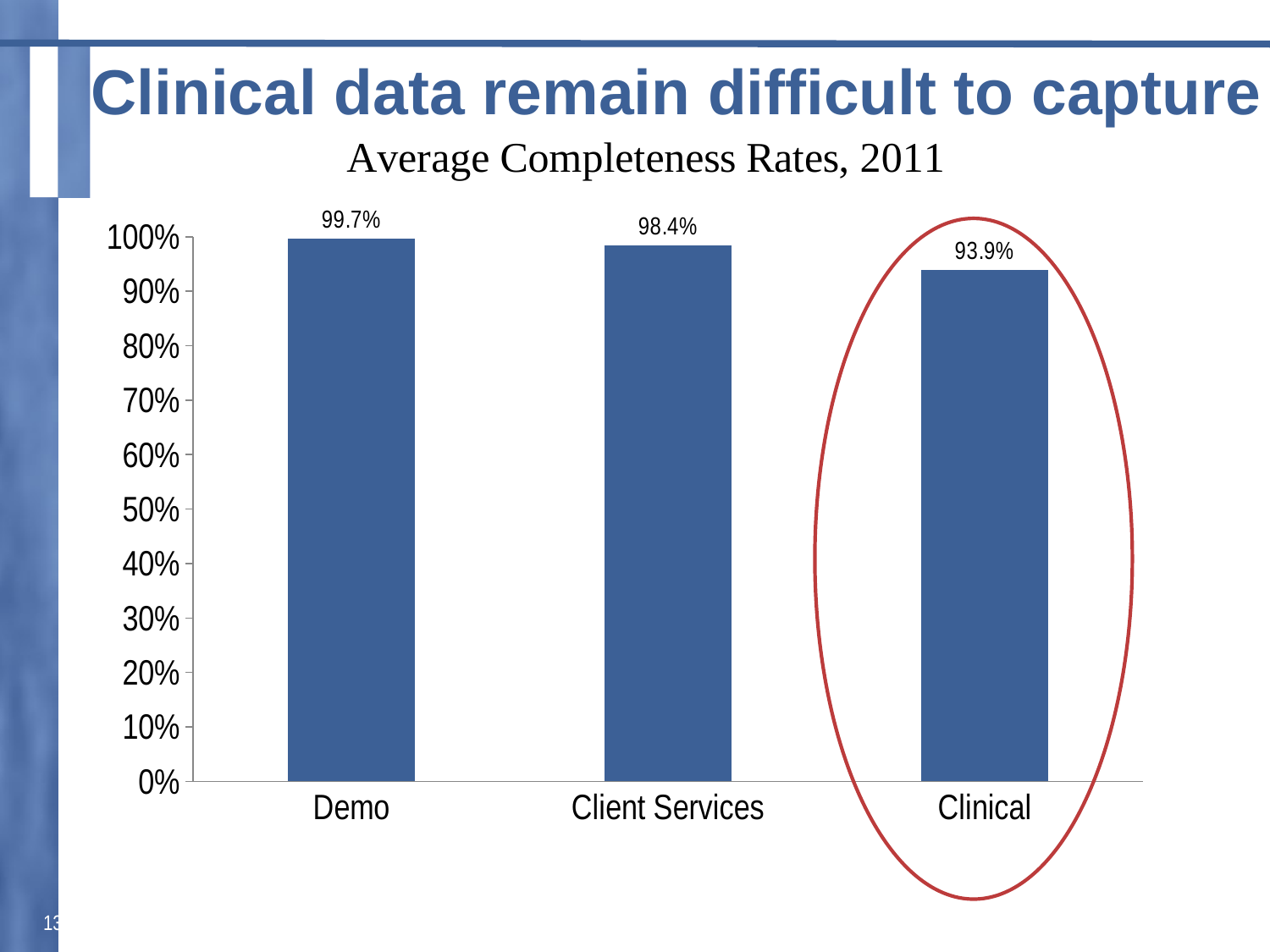
Which category has the highest average completeness rate? Demo What is the average completeness rate for Demo? 99.7% What is the average completeness rate for Client Services? 98.4% Which category is circled in red on the chart? Clinical How many categories are shown in the chart? 3 Which category has the lowest average completeness rate? Clinical What is the average completeness rate for Clinical? 93.9% What kind of chart is shown on the slide? Bar chart Is the value for Clinical greater or less than 90%? greater What is the difference between the completeness rates for Demo and Clinical? 5.8% What is the difference between the completeness rates for Client Services and Clinical? 4.5% Which has a higher completeness rate, Client Services or Clinical? Client Services